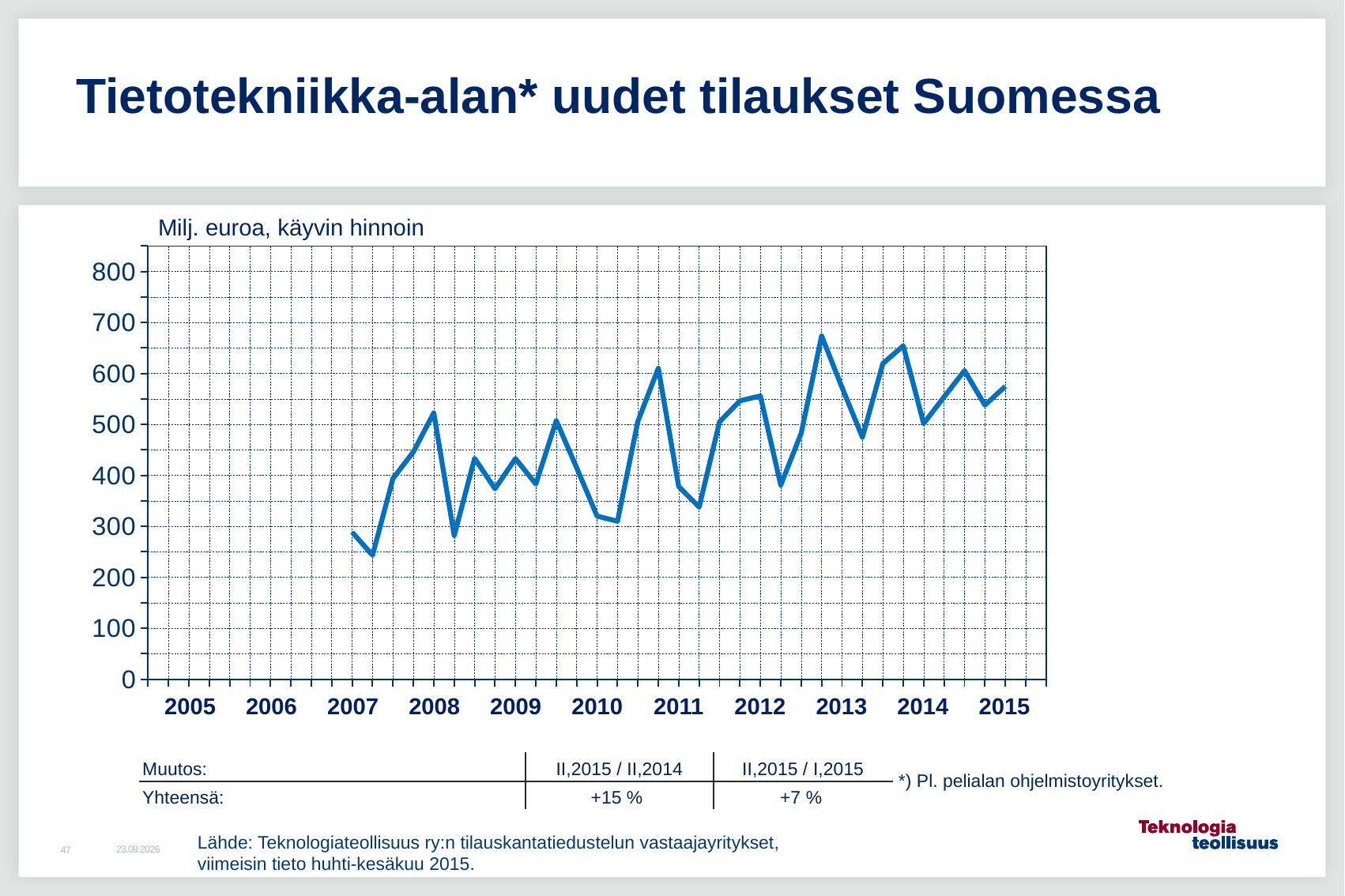
Which is larger: the first plotted value in 2007 or the last plotted value in 2015? 2015 Which is larger: the value at the start of 2010 or the value at the start of 2011? start of 2011 According to the table below the chart, what is the change II,2015 / II,2014 for Yhteensä? +15 % What is the title of the slide's chart? Tietotekniikka-alan* uudet tilaukset Suomessa Is the lowest point of the line, in 2007, greater or less than 300? less Is the highest point of the line, in late 2012, greater or less than 600? greater What unit label is shown above the y axis of the chart? Milj. euroa, käyvin hinnoin Is the last plotted value, at 2015, greater or less than 500? greater What kind of chart is shown on the slide? line chart Overall, do the values rise or fall from 2007 to 2015? rise How many year labels are shown on the x axis of the chart? 11